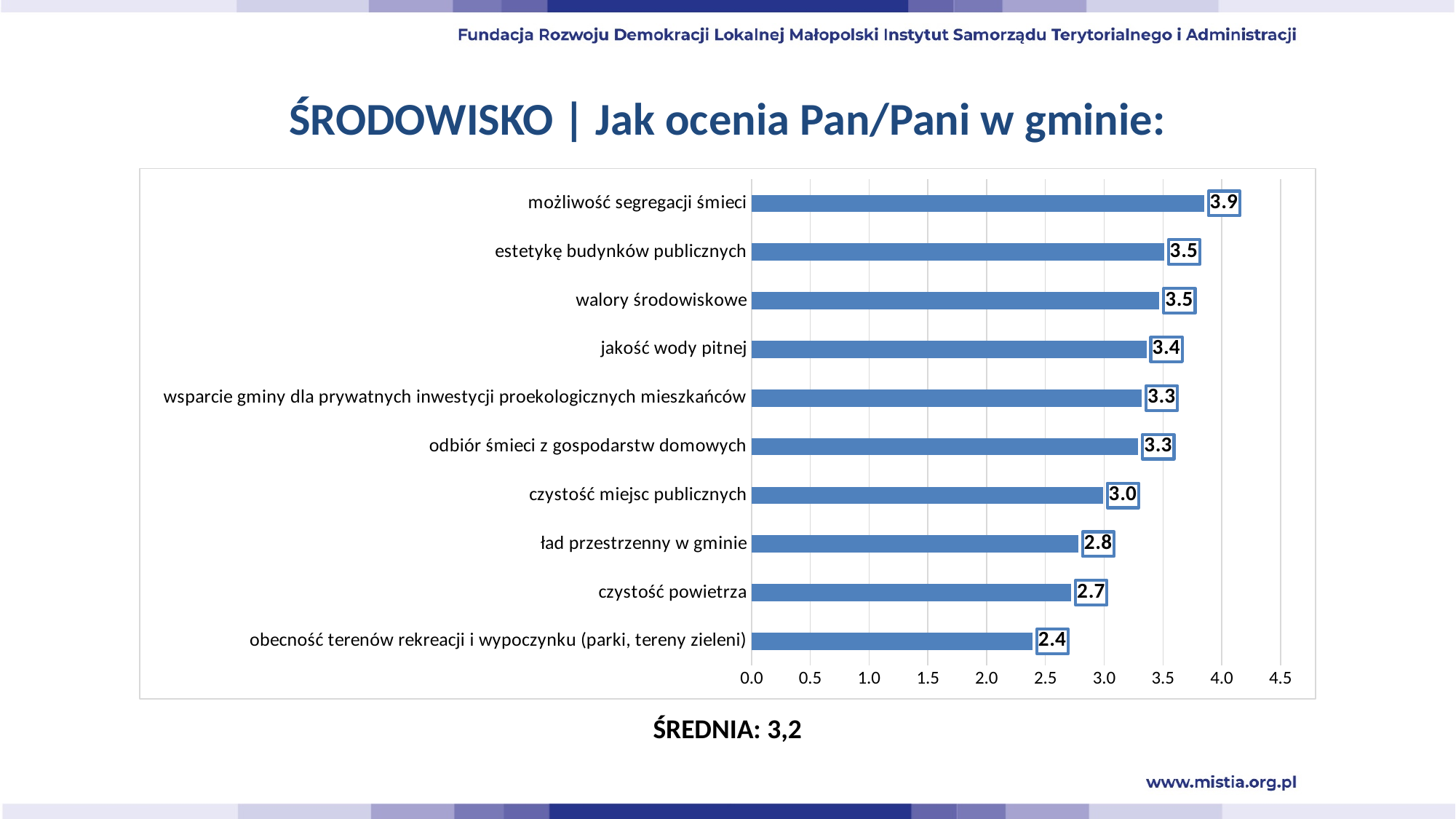
What is the value for "czystość powietrza"? 2.7 How many categories are shown in the chart? 10 What kind of chart is shown on the slide? bar chart What is the value for "jakość wody pitnej"? 3.4 What is the difference between the values for "możliwość segregacji śmieci" and "czystość miejsc publicznych"? 0.9 Is the value for "czystość miejsc publicznych" greater or less than 3.5? less Which category has the highest value? możliwość segregacji śmieci What average (ŚREDNIA) is stated below the chart? 3,2 Which is larger: the value for "ład przestrzenny w gminie" or the value for "czystość powietrza"? ład przestrzenny w gminie What is the value for "obecność terenów rekreacji i wypoczynku (parki, tereny zieleni)"? 2.4 What is the value for "możliwość segregacji śmieci"? 3.9 Which category has the lowest value? obecność terenów rekreacji i wypoczynku (parki, tereny zieleni)